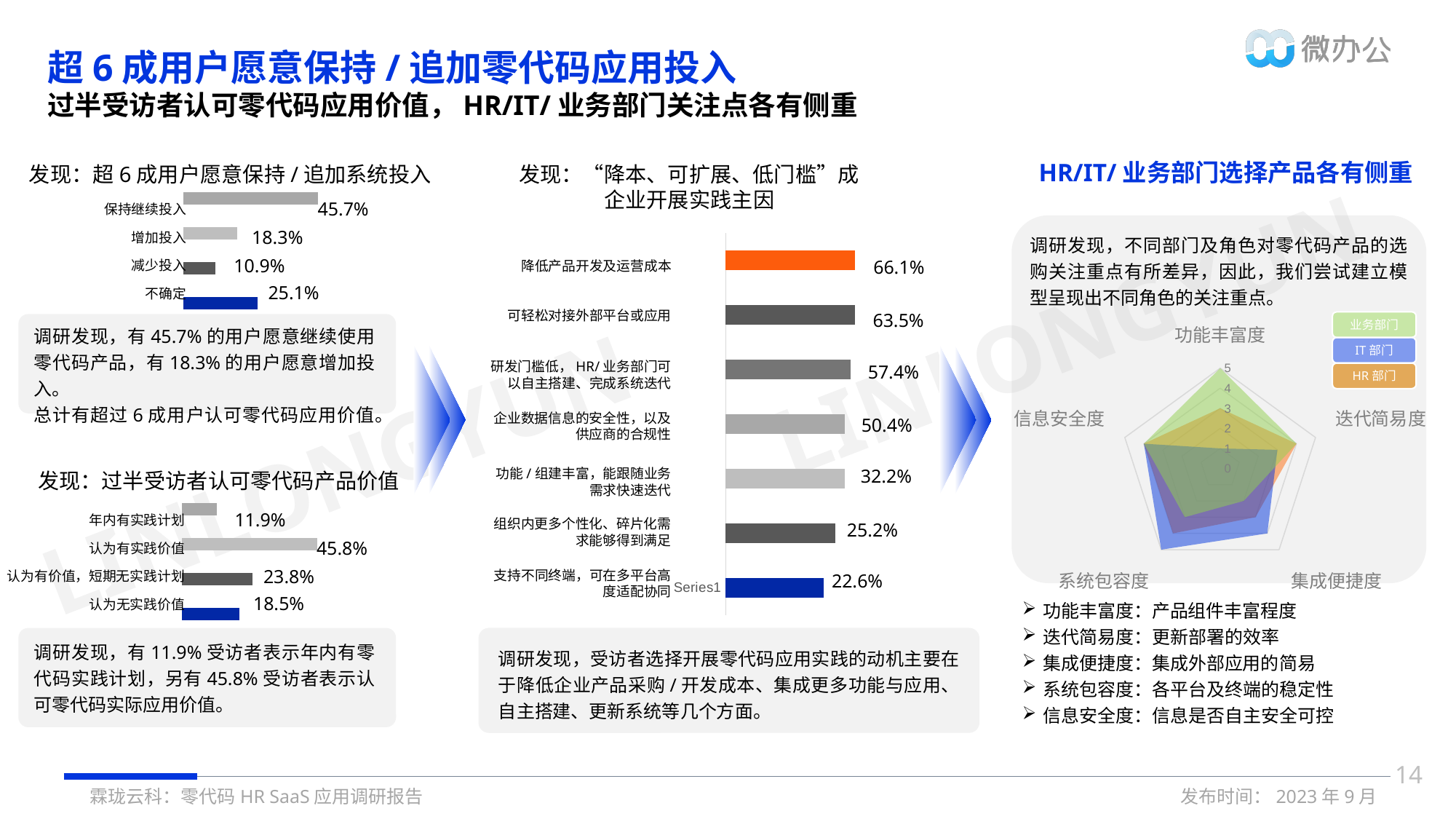
In the radar chart on the right (HR/IT/业务部门选择产品各有侧重), how many series does the legend list? 3 In the top-left bar chart (超6成用户愿意保持/追加系统投入), what is the value for 保持继续投入? 45.7% In the top-left bar chart (超6成用户愿意保持/追加系统投入), what is the difference between 不确定 and 增加投入? 6.8% In the top-left bar chart (超6成用户愿意保持/追加系统投入), which category has the lowest value? 减少投入 In the middle bar chart (企业开展实践主因), how many categories are shown? 7 What kind of chart is the chart on the right (HR/IT/业务部门选择产品各有侧重)? radar chart In the middle bar chart (企业开展实践主因), which category has the highest value? 降低产品开发及运营成本 In the bottom-left bar chart (过半受访者认可零代码产品价值), how many categories are shown? 4 In the middle bar chart (企业开展实践主因), what is the value for 可轻松对接外部平台或应用? 63.5% In the middle bar chart (企业开展实践主因), which is larger: 企业数据信息的安全性，以及供应商的合规性 or 功能/组建丰富，能跟随业务需求快速迭代? 企业数据信息的安全性，以及供应商的合规性 In the bottom-left bar chart (过半受访者认可零代码产品价值), what is the value for 认为有价值，短期无实践计划? 23.8% In the bottom-left bar chart (过半受访者认可零代码产品价值), which category has the highest value? 认为有实践价值